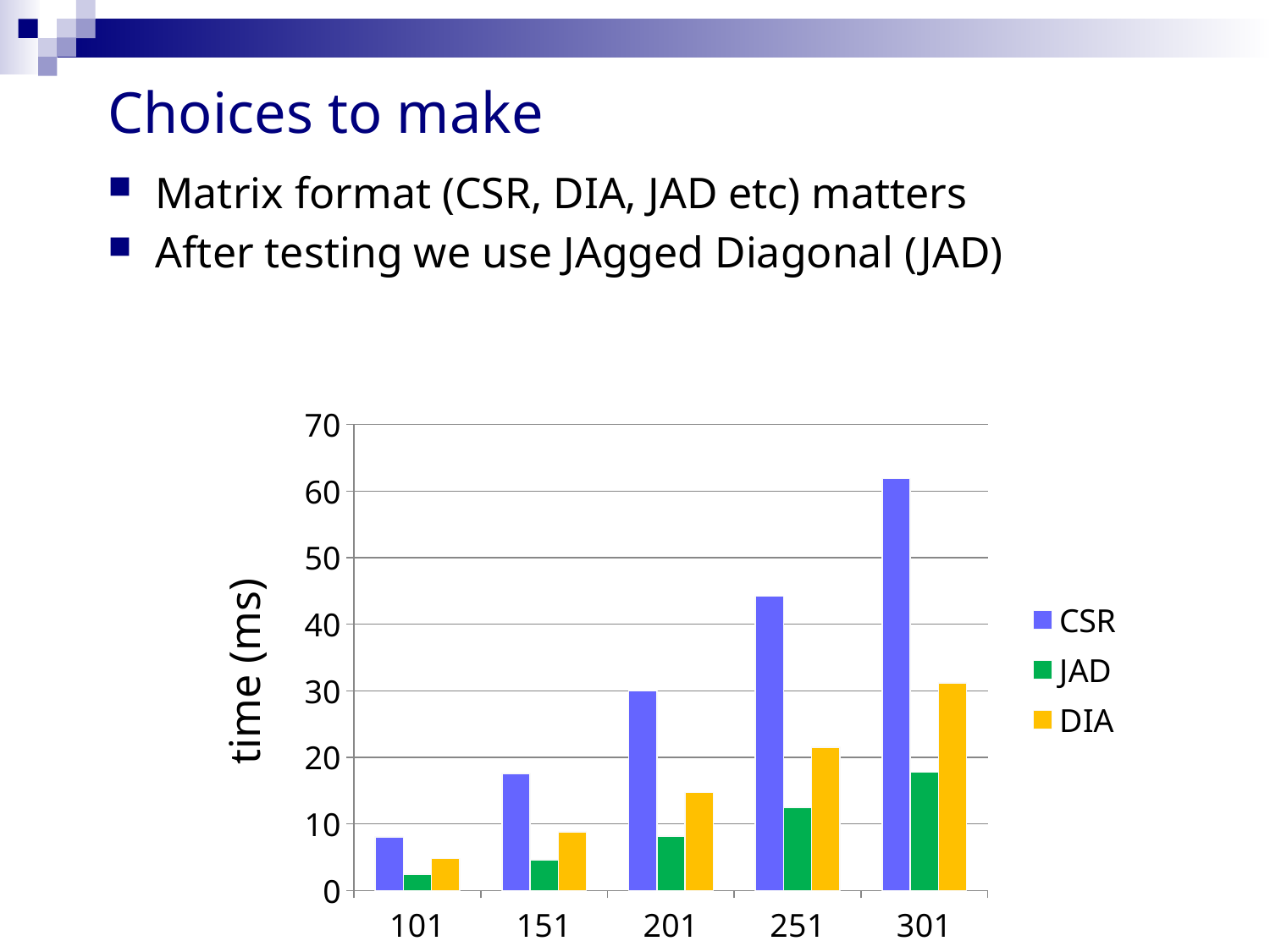
Is the value for CSR at 251 greater or less than 40? greater Is the value for JAD at 301 greater or less than 20? less Which series has the lowest value at 251? JAD Which is larger at 201, the value for DIA or the value for JAD? DIA Which series has the highest value at 301? CSR How many series does the legend list? 3 What is the label of the y axis? time (ms) How many categories are shown on the x axis? 5 Do the CSR values rise or fall as the x axis goes from 101 to 301? rise Is the value for CSR at 301 greater or less than 60? greater What kind of chart is shown on the slide? bar chart